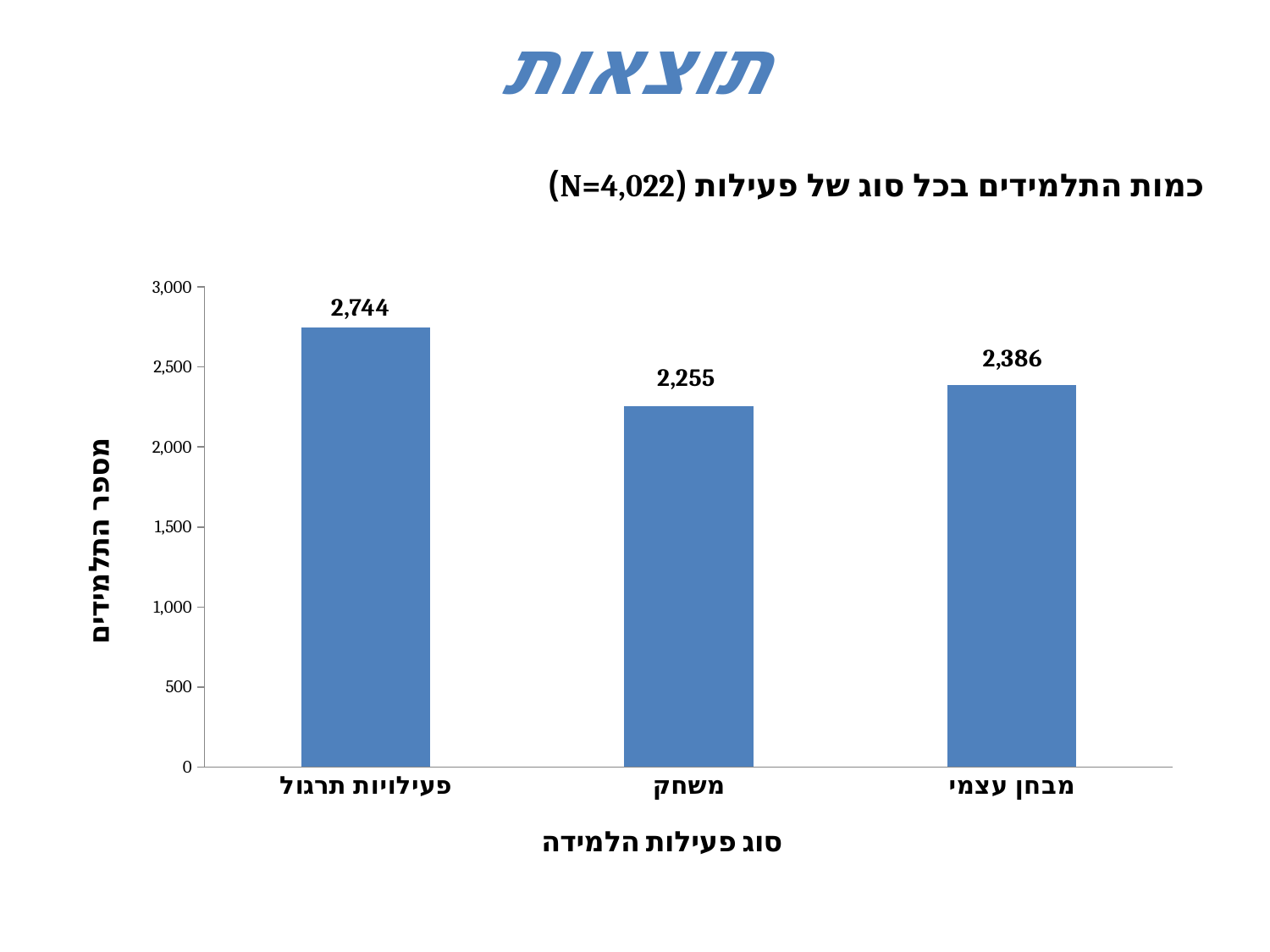
Which is larger, the value for מבחן עצמי or the value for משחק? מבחן עצמי What kind of chart is shown on the slide? bar chart What is the value for פעילויות תרגול? 2,744 Which category has the lowest number of students? משחק What is the difference between the values for מבחן עצמי and משחק? 131 What is the value for משחק? 2,255 What is the label of the y axis? מספר התלמידים What is the difference between the values for פעילויות תרגול and משחק? 489 What is the value for מבחן עצמי? 2,386 Which category has the highest number of students? פעילויות תרגול How many categories are shown on the x axis? 3 Is the value for משחק greater or less than 2,500? less